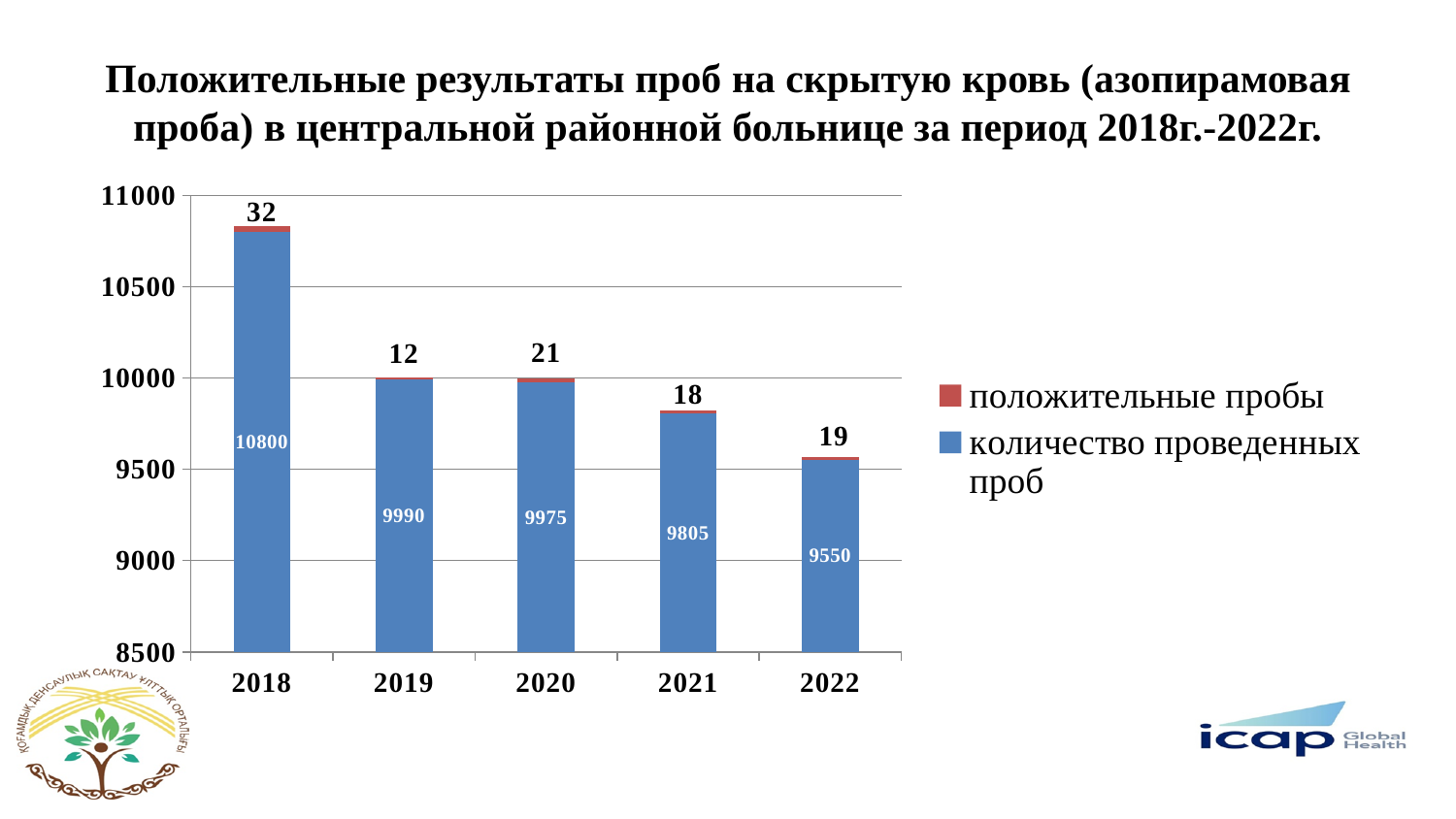
How many series does the legend list? 2 What is the value of "положительные пробы" for 2020? 21 What kind of chart is shown on the slide? Stacked bar chart What is the total of the stacked bar for 2021? 9823 Which year has the lowest value of "количество проведенных проб"? 2022 Which is larger, the "положительные пробы" value for 2021 or for 2022? 2022 Which year has the highest value of "положительные пробы"? 2018 How many years are shown on the x axis? 5 What is the value of "количество проведенных проб" for 2022? 9550 What is the value of "количество проведенных проб" for 2018? 10800 What is the difference between the "количество проведенных проб" values for 2018 and 2019? 810 Which year has the lowest value of "положительные пробы"? 2019